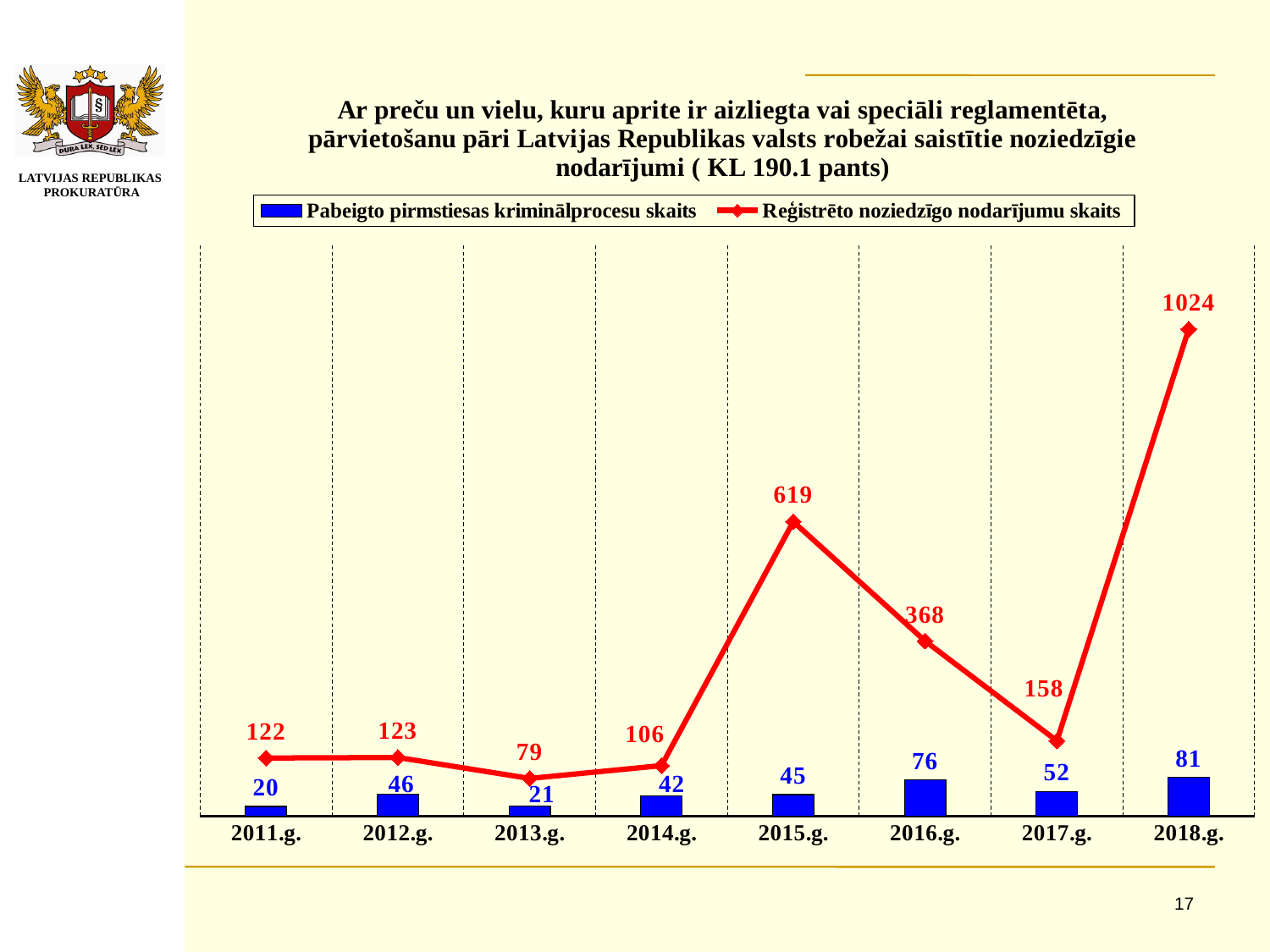
In which year is Reģistrēto noziedzīgo nodarījumu skaits highest? 2018.g. Which is larger: Reģistrēto noziedzīgo nodarījumu skaits in 2015.g. or in 2016.g.? 2015.g. What is the value of Pabeigto pirmstiesas kriminālprocesu skaits for 2016.g.? 76 What is the difference between Pabeigto pirmstiesas kriminālprocesu skaits in 2018.g. and 2017.g.? 29 What kind of chart is this? Combined bar and line chart What is the value of Reģistrēto noziedzīgo nodarījumu skaits for 2018.g.? 1024 In which year is Pabeigto pirmstiesas kriminālprocesu skaits lowest? 2011.g. What is the difference between Reģistrēto noziedzīgo nodarījumu skaits in 2018.g. and 2017.g.? 866 How many series does the legend list? 2 Which series is drawn as a red line with diamond markers? Reģistrēto noziedzīgo nodarījumu skaits How many years are shown on the x axis? 8 What is the value of Reģistrēto noziedzīgo nodarījumu skaits for 2013.g.? 79